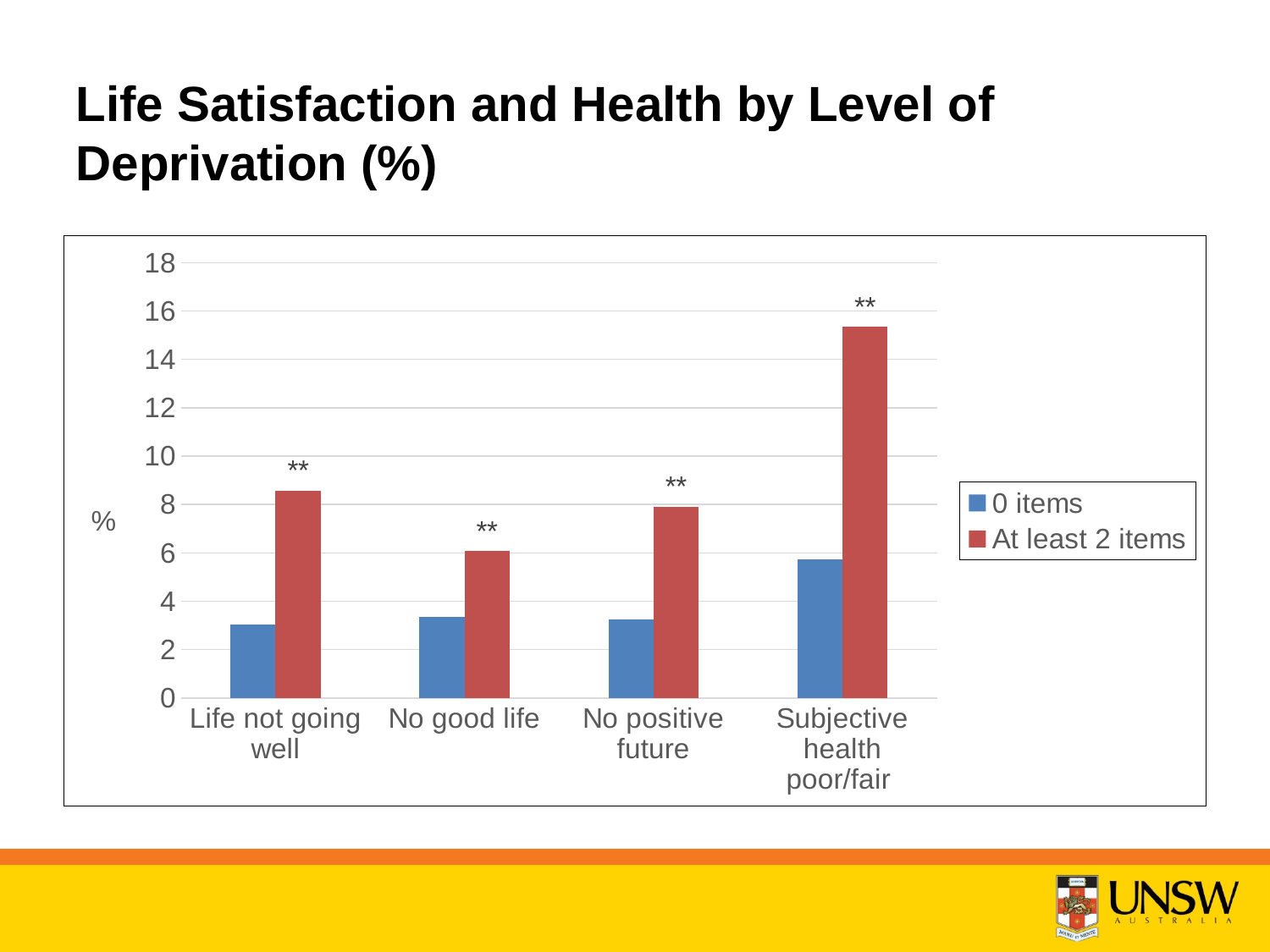
For the '0 items' series, which category has the highest value? Subjective health poor/fair Which is larger: the 'At least 2 items' value for 'No positive future' or the 'At least 2 items' value for 'No good life'? No positive future Is the value for 'At least 2 items' in the 'Subjective health poor/fair' category greater or less than 14? greater What are the two series named in the legend? 0 items; At least 2 items What kind of chart is shown on the slide? bar chart For the 'At least 2 items' series, which category has the lowest value? No good life What is the title of the slide containing the chart? Life Satisfaction and Health by Level of Deprivation (%) How many series does the legend list? 2 For the 'At least 2 items' series, which category has the highest value? Subjective health poor/fair Is the value for 'At least 2 items' in the 'No good life' category greater or less than 8? less Is the value for '0 items' in the 'Life not going well' category greater or less than 4? less How many categories are shown on the x axis of the chart? 4